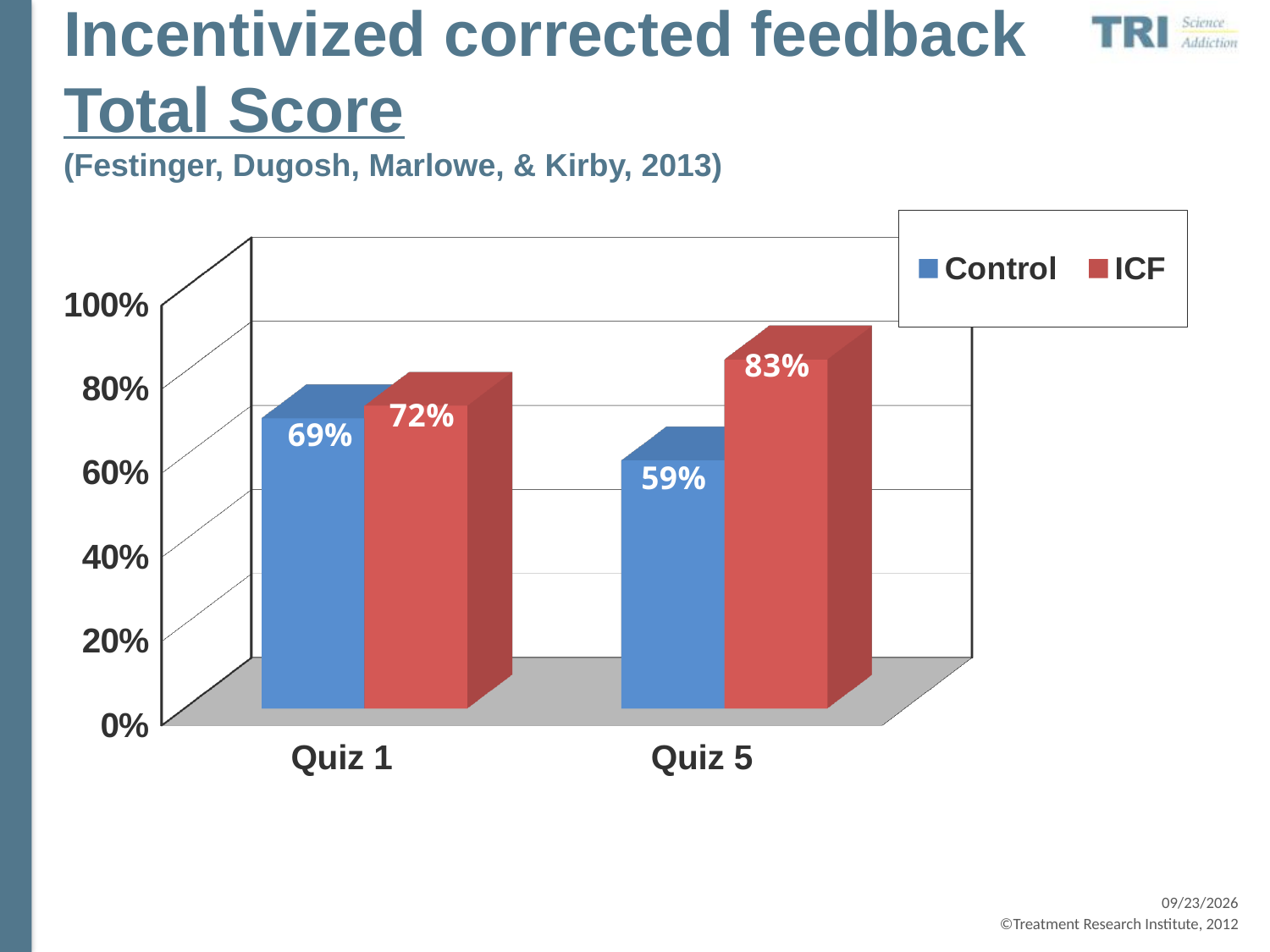
What is the difference between the ICF and Control values at Quiz 1? 3% What is the value for Control at Quiz 1? 69% How many series does the legend list? 2 What is the value for ICF at Quiz 5? 83% What is the value for Control at Quiz 5? 59% What is the value for ICF at Quiz 1? 72% What kind of chart is shown on the slide? Bar chart Which is larger at Quiz 5, Control or ICF? ICF How many categories are shown on the x axis? 2 Which bar has the highest value on the chart? ICF at Quiz 5 What is the difference between the ICF and Control values at Quiz 5? 24% Which bar has the lowest value on the chart? Control at Quiz 5